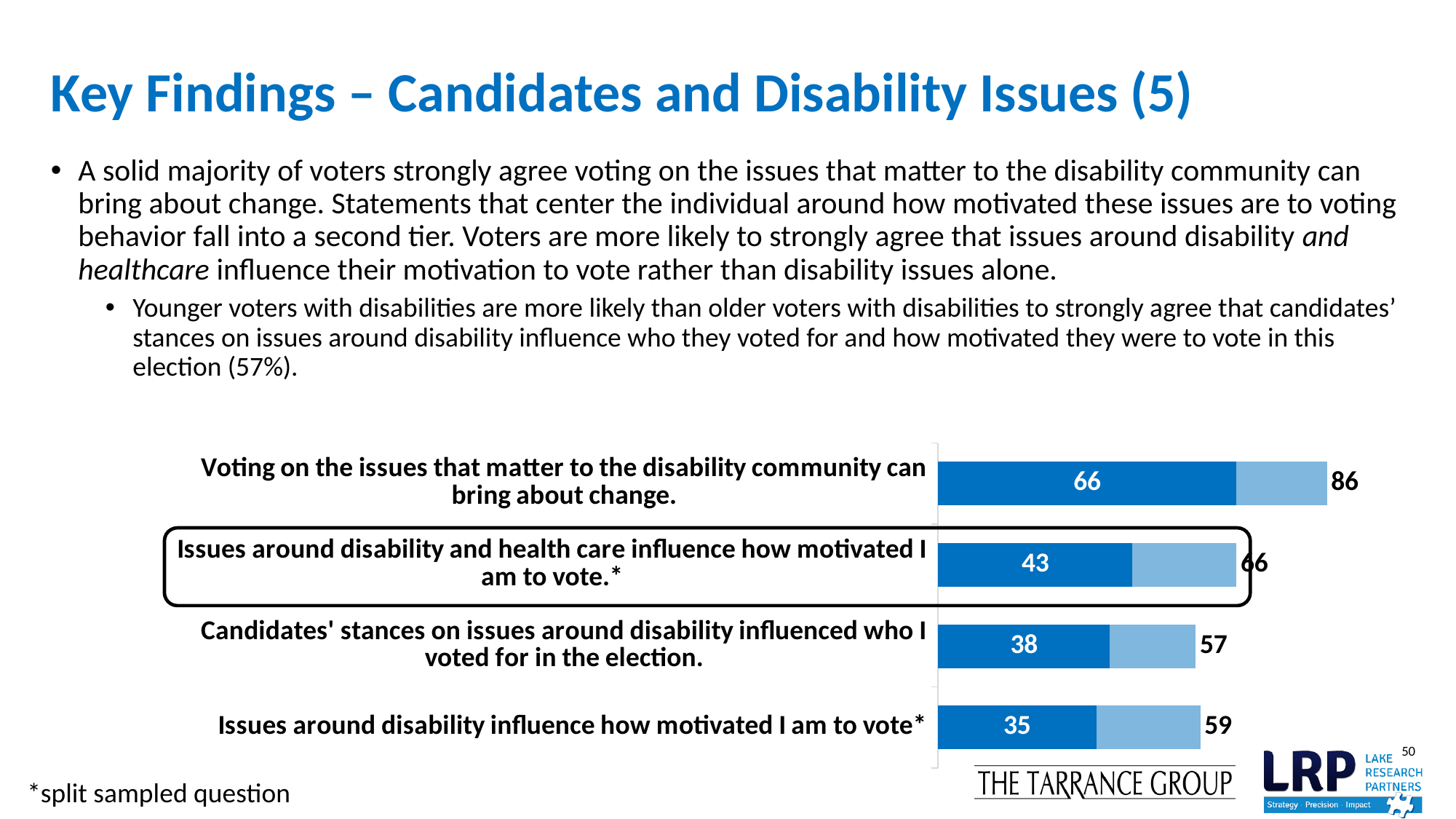
What kind of chart is shown on the slide? Stacked bar chart What is the difference between the total value and the dark blue value for "Voting on the issues that matter to the disability community can bring about change."? 20 What is the total value shown for "Issues around disability influence how motivated I am to vote*"? 59 What is the total value shown at the end of the bar for "Issues around disability and health care influence how motivated I am to vote.*"? 66 What is the dark blue value for "Candidates' stances on issues around disability influenced who I voted for in the election."? 38 Which statement on the chart is outlined with a black box? Issues around disability and health care influence how motivated I am to vote.* How many statements (categories) are plotted in the chart? 4 What is the dark blue (strongly agree) value for "Voting on the issues that matter to the disability community can bring about change."? 66 What is the difference between the dark blue values for "Issues around disability and health care influence how motivated I am to vote.*" and "Issues around disability influence how motivated I am to vote*"? 8 Which has a larger total value: "Candidates' stances on issues around disability influenced who I voted for in the election." or "Issues around disability influence how motivated I am to vote*"? Issues around disability influence how motivated I am to vote* Which statement has the highest total value? Voting on the issues that matter to the disability community can bring about change. Which statement has the lowest dark blue (strongly agree) value? Issues around disability influence how motivated I am to vote*